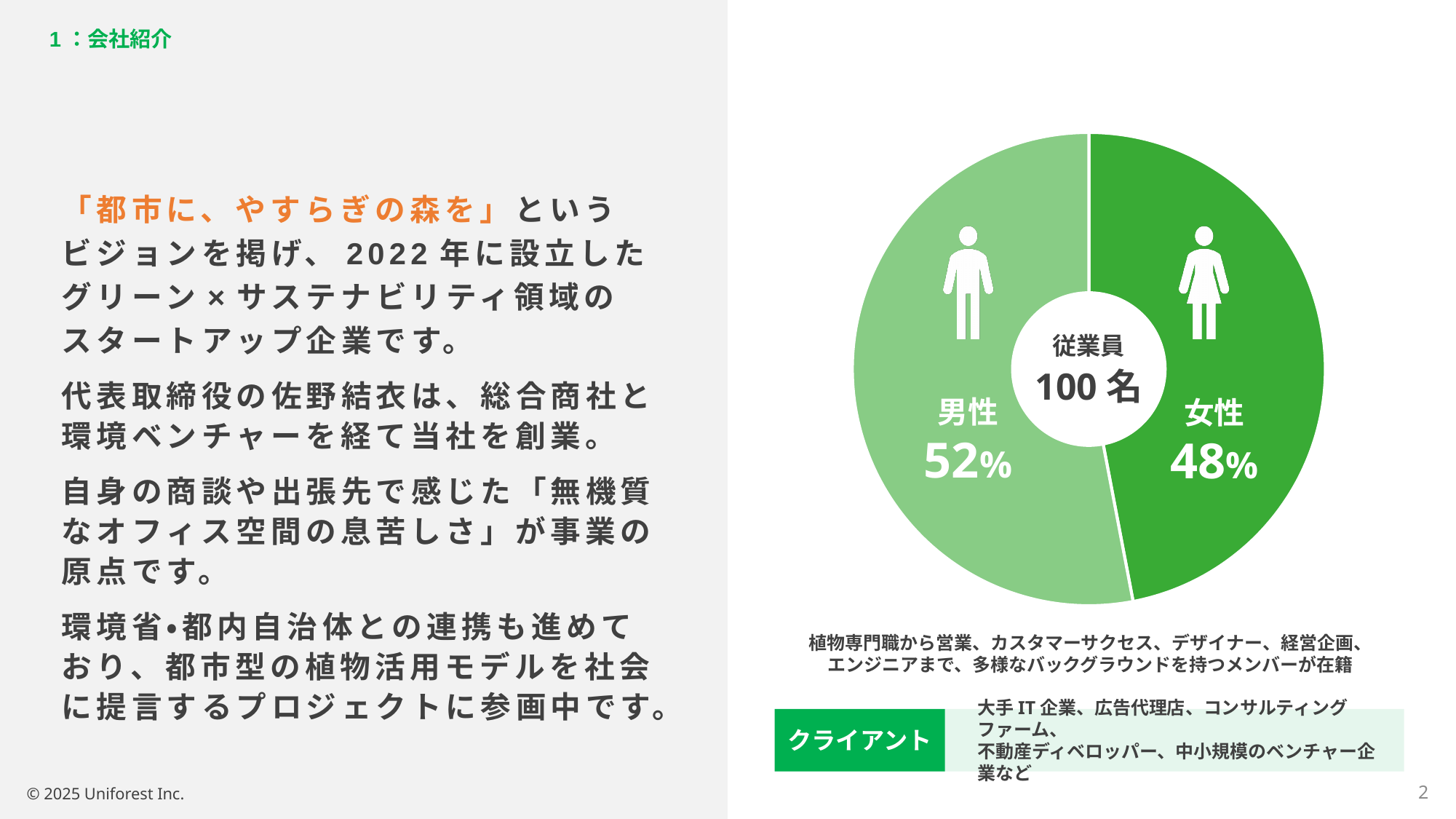
Which category has the smaller share of the pie chart? 女性 What total number of employees is shown in the center of the chart? 100名 Which slice of the chart is drawn in the darker green, 男性 or 女性? 女性 Is the share for 女性 greater or less than the share for 男性? less What label appears in the center of the donut chart above the number? 従業員 What kind of chart is shown on the right side of the slide? Pie chart (donut) What percentage of employees are 女性 (female) according to the chart? 48% How many categories does the pie chart divide employees into? 2 What share of the pie does the 男性 slice represent? 52% Which category has the larger share of the pie chart, 男性 or 女性? 男性 What is the difference in percentage points between the 男性 and 女性 shares? 4 percentage points What percentage of employees are 男性 (male) according to the chart? 52%